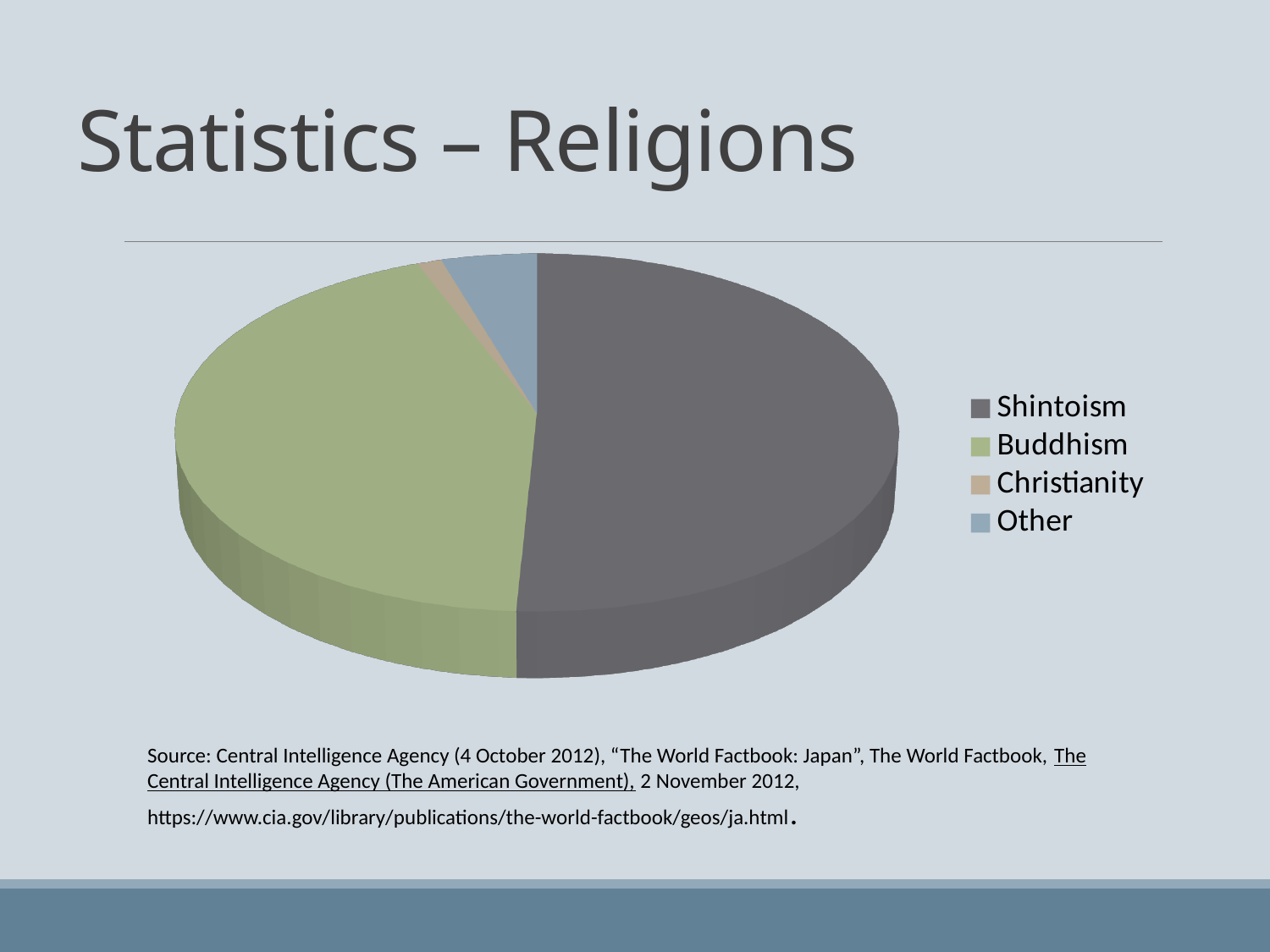
Which legend entry is shown in green? Buddhism Which religion has the largest slice of the pie chart? Shintoism Which slice is larger, Buddhism or Other? Buddhism Which religion has the smallest slice of the pie chart? Christianity What is the title of the slide containing the pie chart? Statistics – Religions Which slice is larger, Other or Christianity? Other How many entries does the legend list? 4 What kind of chart is shown on the slide? Pie chart Which slice is larger, Shintoism or Buddhism? Shintoism How many slices does the pie chart have? 4